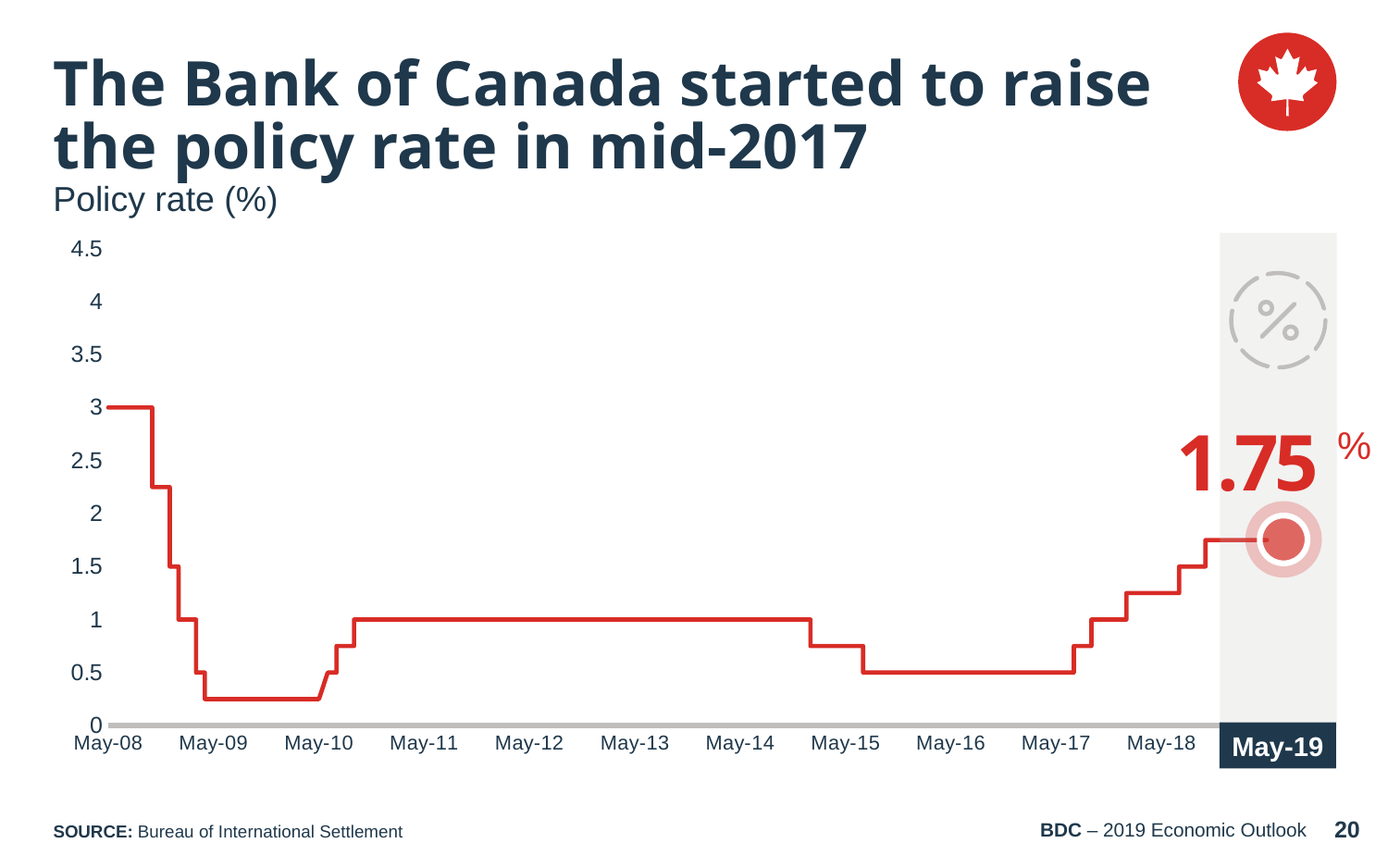
Is the policy rate at May-18 greater or less than 1? greater Does the policy rate rise or fall between May-08 and May-09? fall How many date labels are shown on the x axis? 12 What is the subtitle label above the chart describing the plotted measure? Policy rate (%) Does the policy rate rise or fall between May-17 and May-19? rise Which x-axis date has the highest policy rate on the chart? May-08 What kind of chart is used to show the policy rate? line chart Which has the higher policy rate, May-18 or May-19? May-19 What is the policy rate shown for May-19? 1.75% Is the policy rate at May-16 greater or less than 1? less Is the policy rate at May-12 greater or less than 1.5? less What is the policy rate at May-08, the start of the line? 3